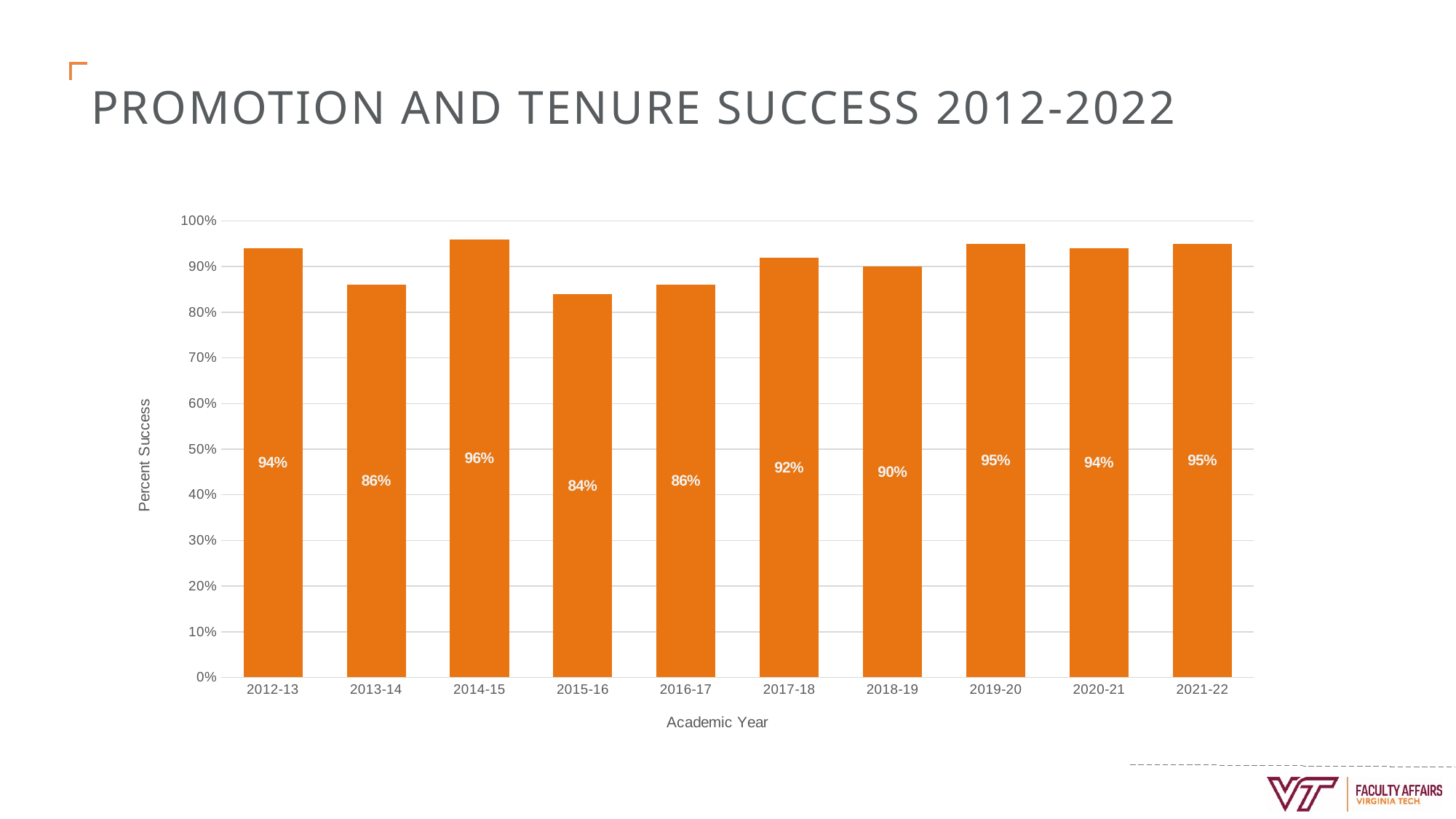
What is the difference in percent success between 2017-18 and 2013-14? 6% What is the difference in percent success between 2014-15 and 2015-16? 12% Is the value for 2015-16 greater or less than 90%? less Which academic year has the lowest percent success? 2015-16 How many academic years are shown on the chart? 10 What is the label of the vertical axis? Percent Success What is the percent success for 2014-15? 96% What is the percent success for 2018-19? 90% Which academic year has the highest percent success? 2014-15 What kind of chart is shown on the slide? Bar chart Which has a higher percent success, 2012-13 or 2016-17? 2012-13 What is the percent success for 2021-22? 95%